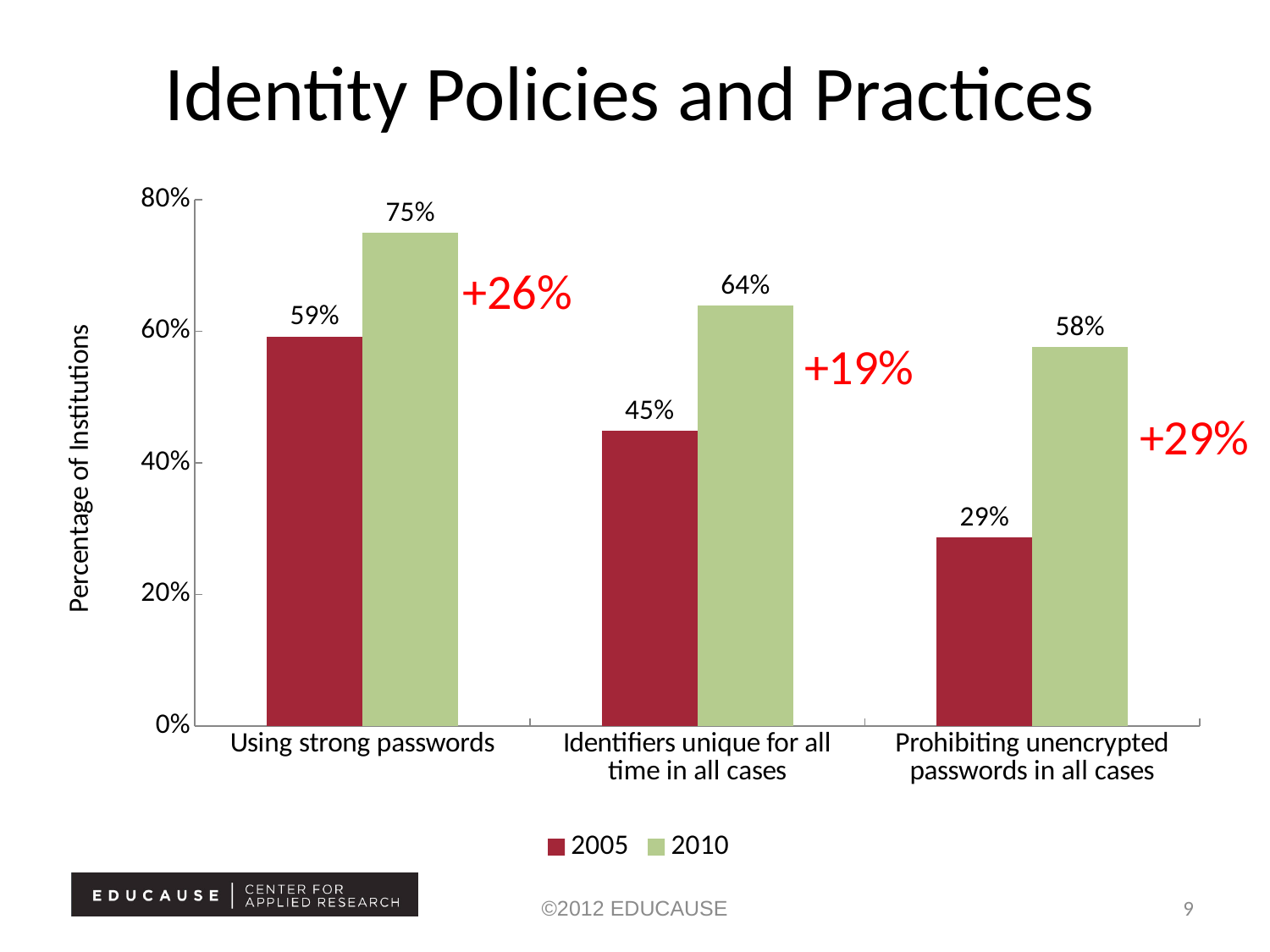
What is the 2005 value for Identifiers unique for all time in all cases? 45% What is the 2005 value for Prohibiting unencrypted passwords in all cases? 29% What is the difference between the 2010 and 2005 values for Identifiers unique for all time in all cases? 19% What is the 2010 value for Using strong passwords? 75% What kind of chart is shown on the slide? Bar chart Which category has the highest 2010 value? Using strong passwords Which category has the lowest 2005 value? Prohibiting unencrypted passwords in all cases How many categories are shown on the x axis? 3 What is the label of the y axis? Percentage of Institutions What is the difference between the 2010 and 2005 values for Prohibiting unencrypted passwords in all cases? 29% How many series does the legend list? 2 Which is larger: the 2005 value for Using strong passwords or the 2010 value for Prohibiting unencrypted passwords in all cases? 2005 value for Using strong passwords